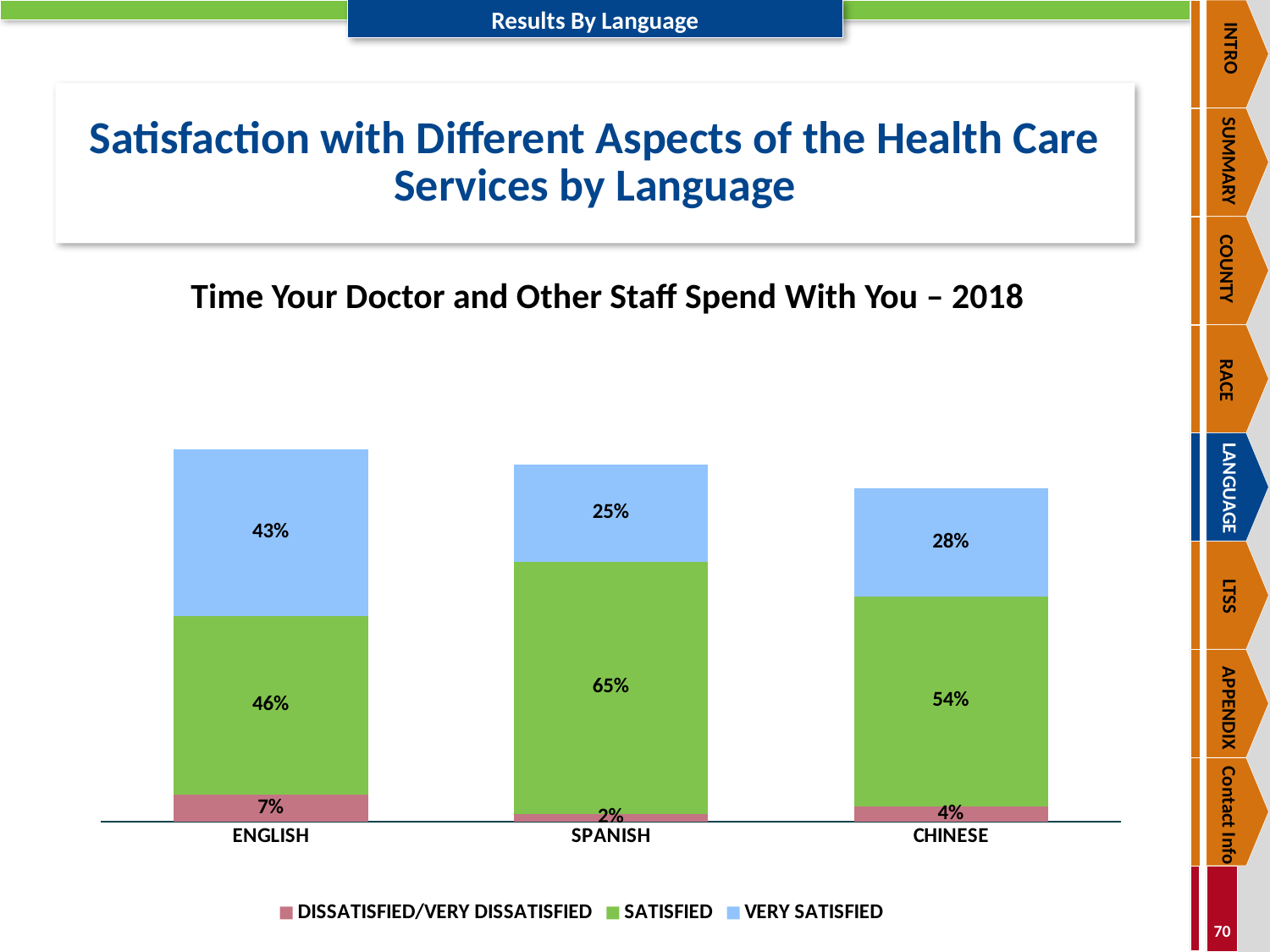
What kind of chart is shown on the slide? Stacked bar chart What percentage of Chinese speakers were Dissatisfied/Very Dissatisfied? 4% What percentage of English speakers were Very Satisfied with the time their doctor and other staff spend with them? 43% Which colour represents the Satisfied series in the legend? Green Which is larger: the Very Satisfied percentage for Chinese speakers or for Spanish speakers? Chinese What is the difference between the Very Satisfied percentages for English and Spanish speakers? 18% What percentage of Spanish speakers were Satisfied? 65% How many series does the legend list? 3 What is the total of the Chinese bar? 86% How many language groups are shown on the chart? 3 Which language group has the highest Satisfied percentage? Spanish Which language group has the lowest Dissatisfied/Very Dissatisfied percentage? Spanish